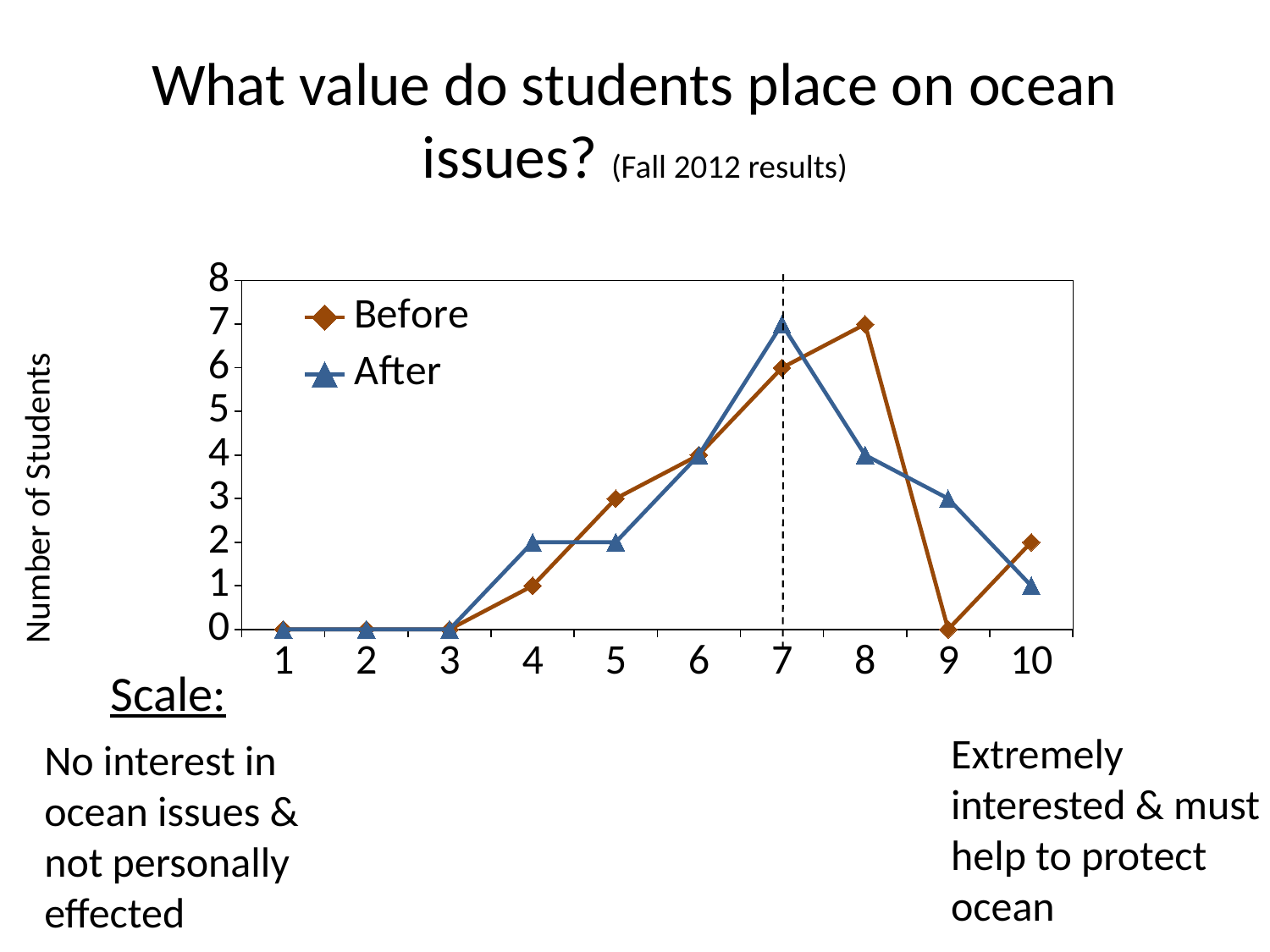
At which scale value does the Before series reach its highest number of students? 8 How many scale points are shown along the x axis? 10 What is the number of students for the Before series at scale value 8? 7 Does the After series rise or fall from scale value 7 to scale value 10? Fall How many series does the legend list? 2 What is the difference between the Before and After values at scale value 8? 3 What is the number of students for the After series at scale value 7? 7 What kind of chart is shown on the slide? Line chart At scale value 9, which series has the larger number of students, Before or After? After What is the label on the y axis? Number of Students At which scale value does the After series reach its highest number of students? 7 What is the number of students for the Before series at scale value 9? 0